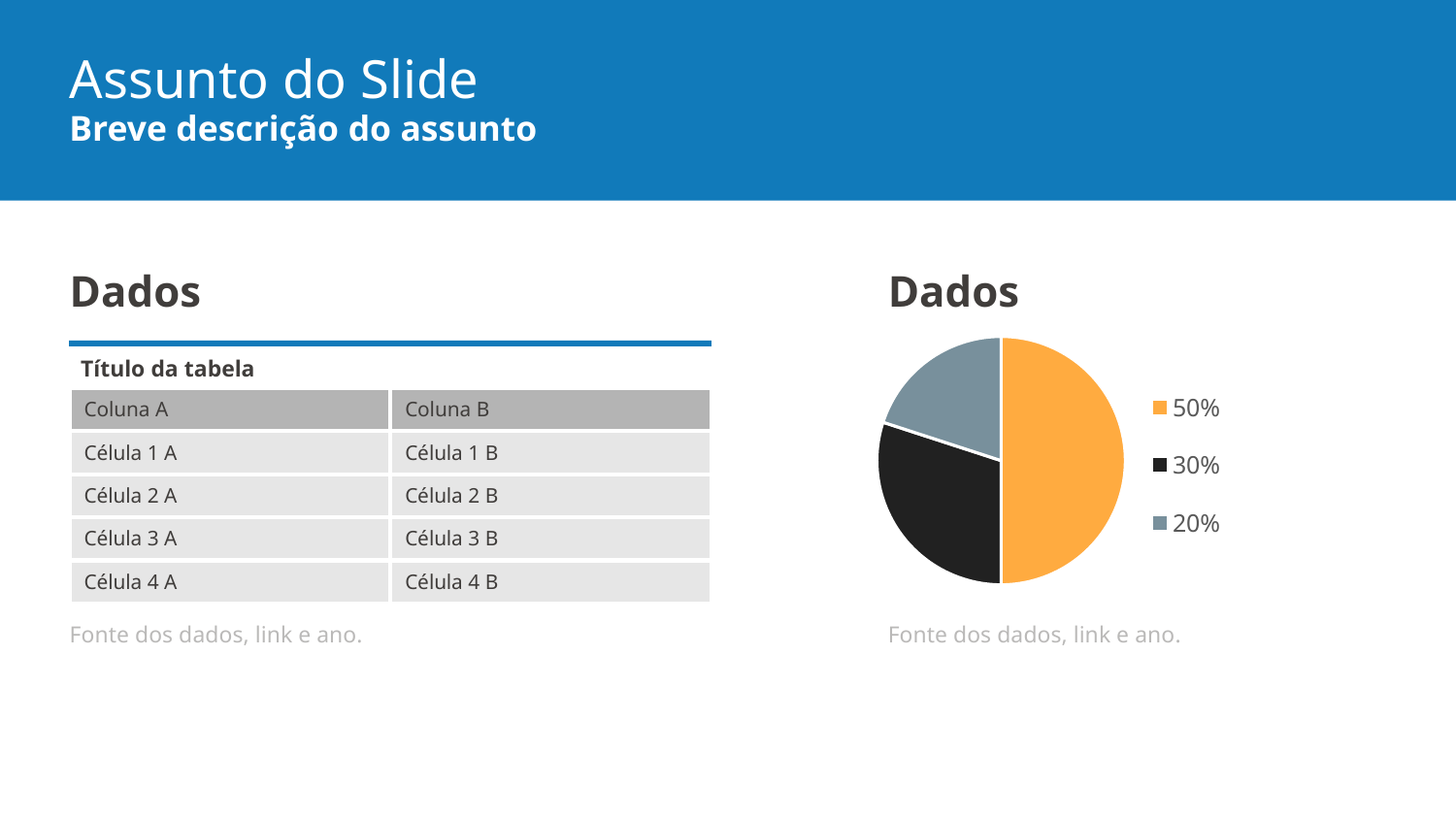
How many entries does the pie chart's legend list? 3 How many slices does the pie chart have? 3 What share of the pie chart does the orange slice represent? 50% Which legend entry corresponds to the smallest slice of the pie chart? 20% What kind of chart is shown on the right side of the slide? pie chart What is the difference between the largest and smallest slices of the pie chart? 30% What is the title of the pie chart? Dados What share of the pie chart does the grey-blue slice represent? 20% In the pie chart, which slice is larger: the orange slice or the dark slice? the orange slice What colour is the slice labelled 30% in the pie chart's legend? dark grey/black Which legend entry corresponds to the largest slice of the pie chart? 50%